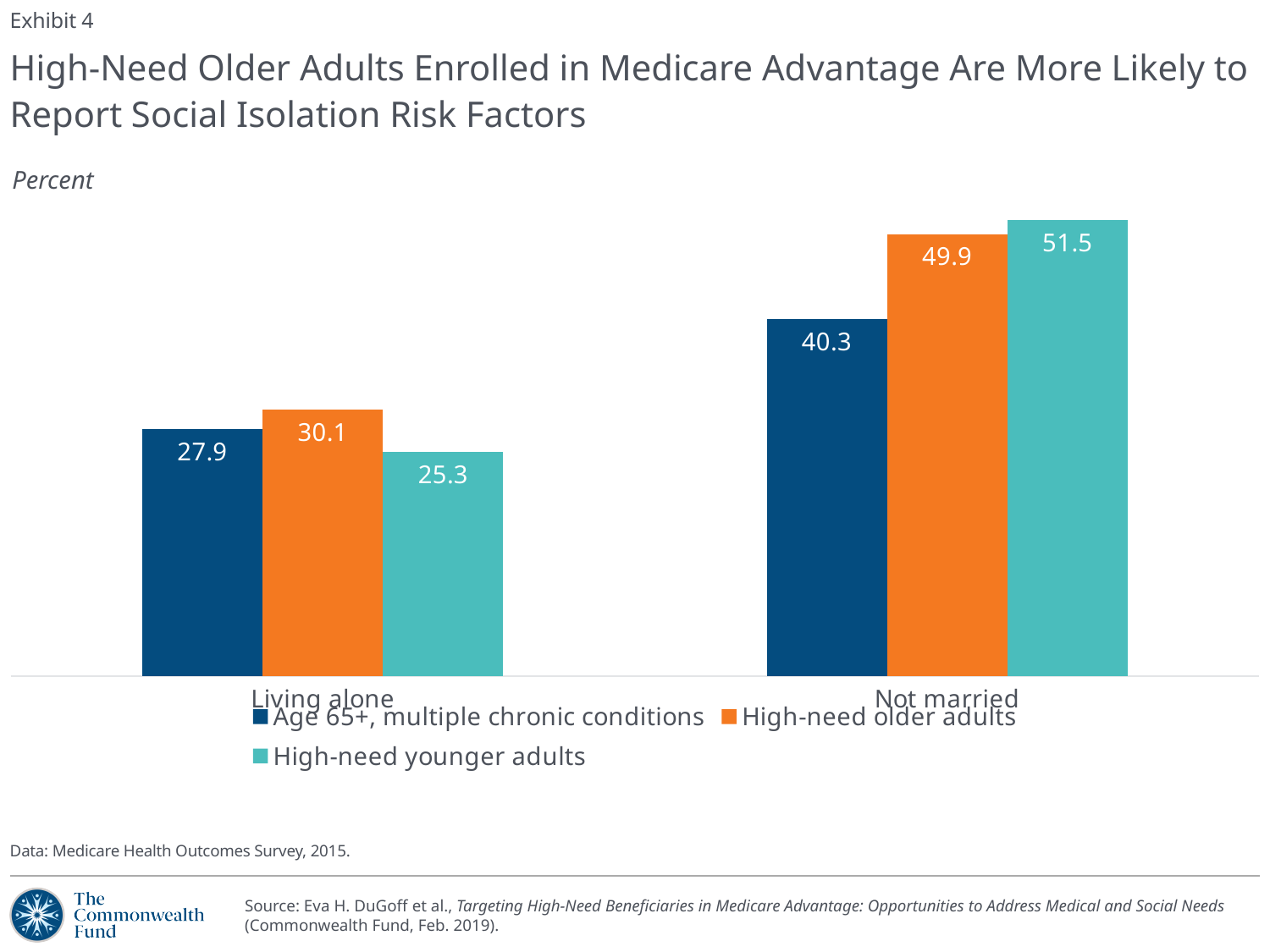
What unit is indicated above the chart? Percent What is the difference between the High-need older adults value and the High-need younger adults value in the Living alone category? 4.8 Which series has the highest value in the Not married category? High-need younger adults Which series has the lowest value in the Living alone category? High-need younger adults How many series does the legend list? 3 What is the difference between the High-need older adults value and the Age 65+, multiple chronic conditions value in the Not married category? 9.6 What is the value for Age 65+, multiple chronic conditions in the Not married category? 40.3 What is the value for High-need younger adults in the Not married category? 51.5 What is the value for High-need older adults in the Living alone category? 30.1 What kind of chart is shown on the slide? Bar chart How many categories are shown on the x axis? 2 Which is larger: the Age 65+, multiple chronic conditions value for Living alone or for Not married? Not married